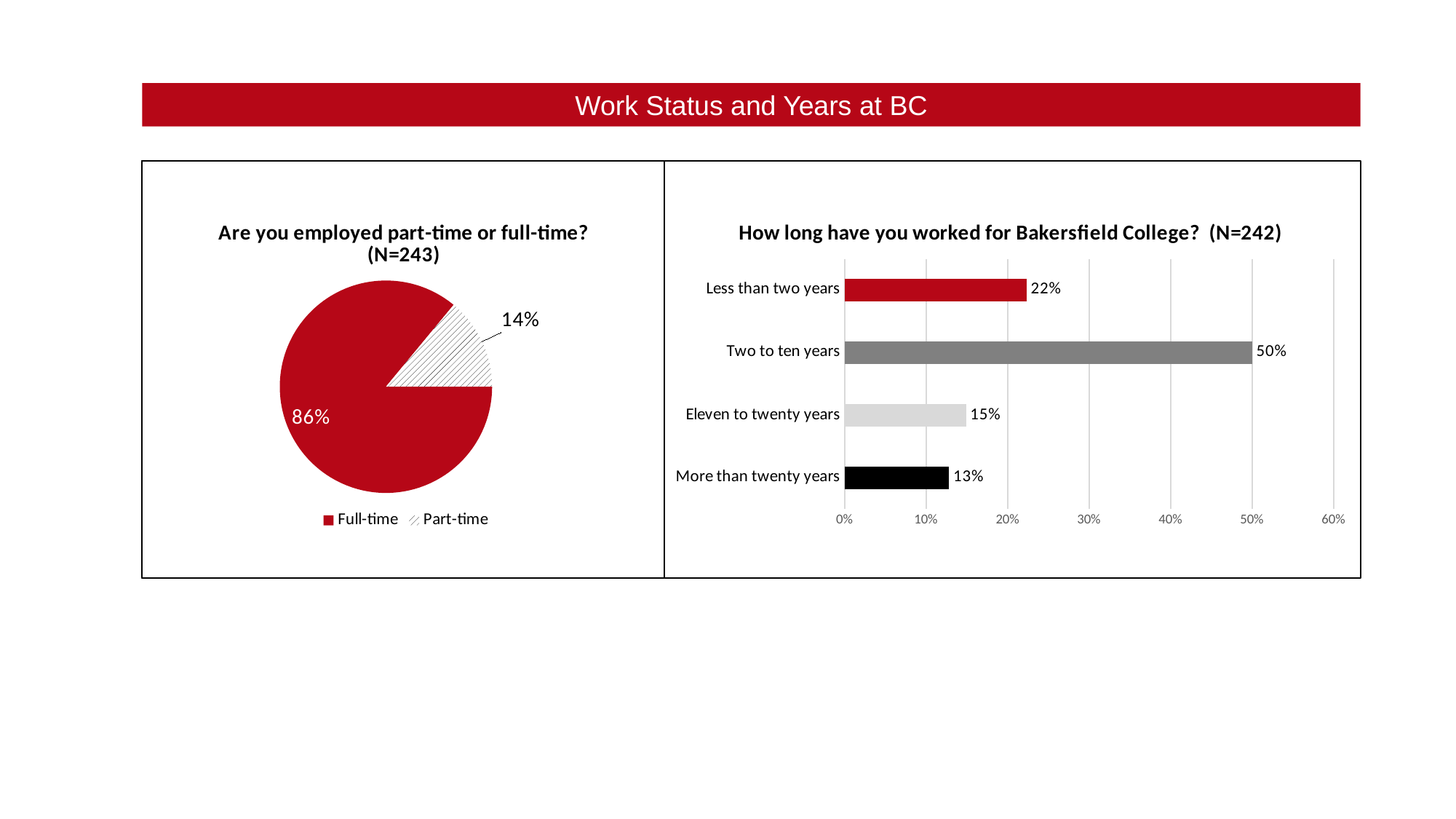
In the chart 'How long have you worked for Bakersfield College?', what is the value for 'More than twenty years'? 13% What kind of chart is the chart on the left of the slide? Pie chart What kind of chart is 'How long have you worked for Bakersfield College?'? Bar chart In the chart 'How long have you worked for Bakersfield College?', what is the difference between 'Two to ten years' and 'Less than two years'? 28% In the pie chart 'Are you employed part-time or full-time?', which category has the larger slice? Full-time In the chart 'How long have you worked for Bakersfield College?', what is the value for 'Two to ten years'? 50% In the chart 'How long have you worked for Bakersfield College?', how many categories are shown? 4 In the pie chart 'Are you employed part-time or full-time?', what share of respondents are part-time? 14% In the chart 'How long have you worked for Bakersfield College?', which category has the highest value? Two to ten years In the chart 'How long have you worked for Bakersfield College?', which category has the lowest value? More than twenty years In the pie chart 'Are you employed part-time or full-time?', what share of respondents are full-time? 86% In the pie chart 'Are you employed part-time or full-time?', how many entries does the legend list? 2